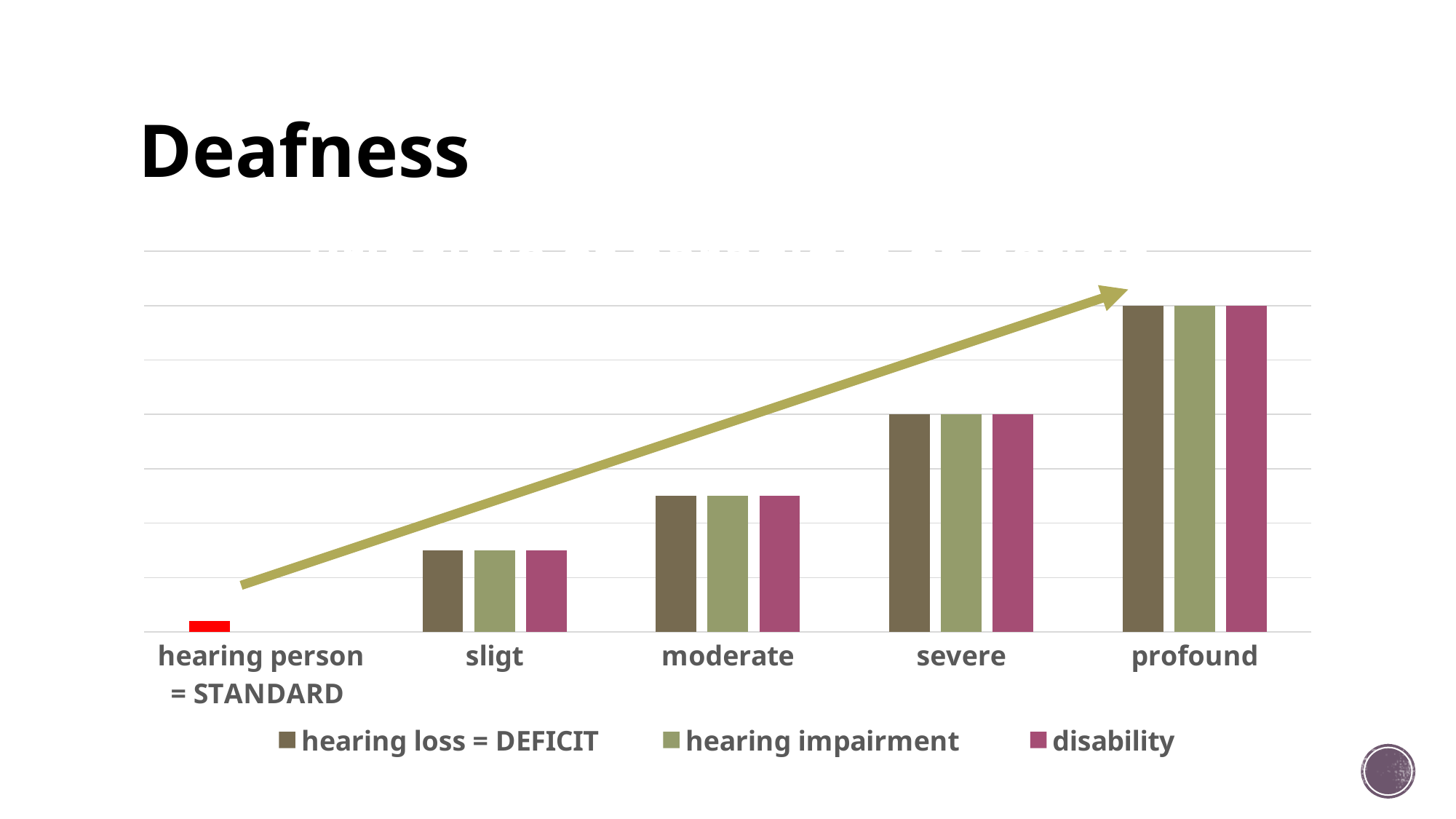
Which category has the lowest bar in the chart? hearing person = STANDARD What colour is the bar for the hearing person = STANDARD category? red How many categories are shown along the x axis of the chart? 5 Which category has taller bars, severe or moderate? severe What are the three series named in the chart's legend? hearing loss = DEFICIT, hearing impairment, disability What kind of chart is shown on the slide? bar chart Do the bar heights rise or fall from left to right along the x axis? rise How many series does the chart's legend list? 3 Which category has taller bars, moderate or sligt? moderate Which category has taller bars, sligt or profound? profound Which category has the tallest bars in the chart? profound